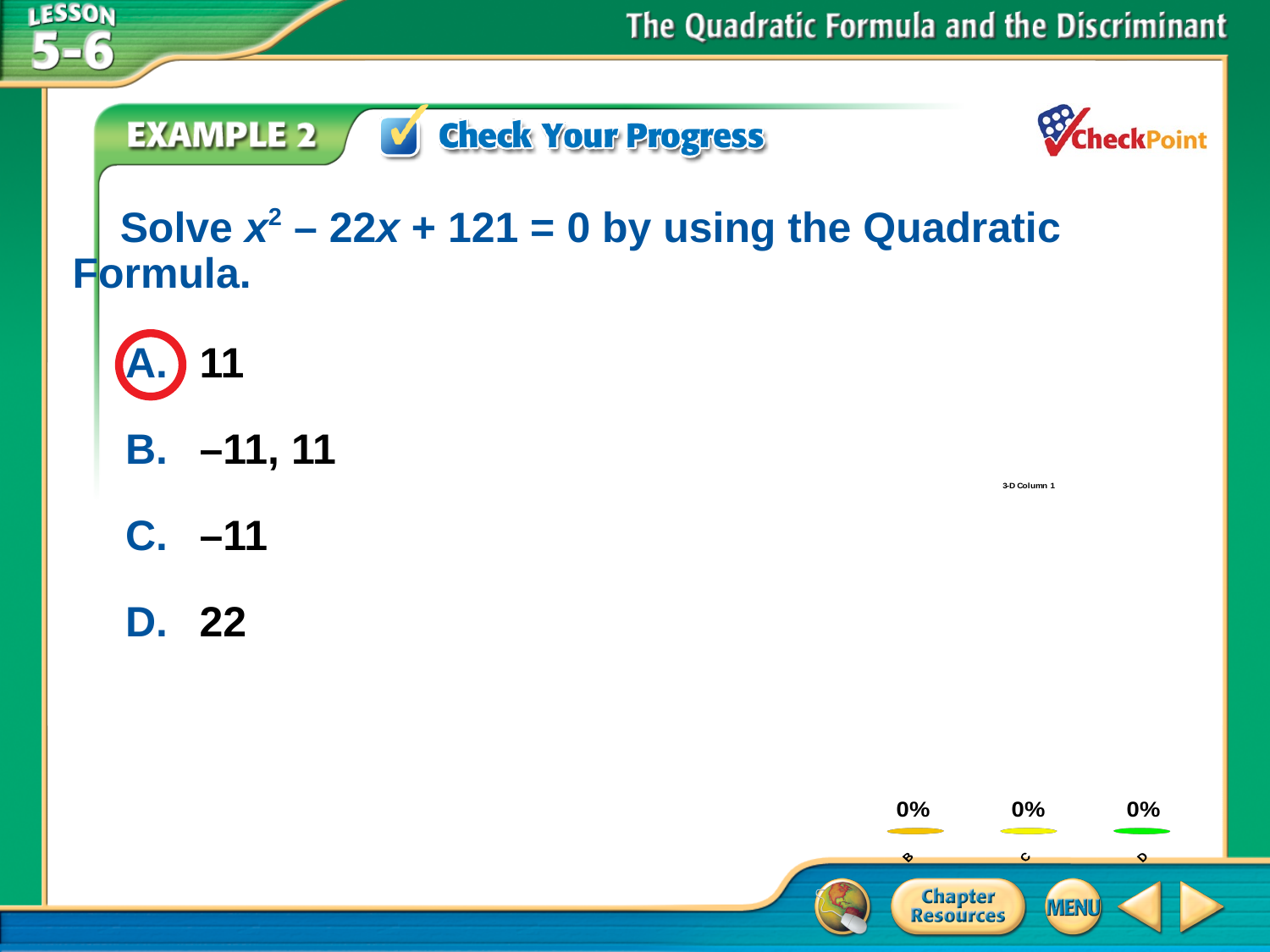
What kind of chart is shown at the bottom right of the slide? bar chart In the chart at the bottom right, what colour is the bar for category D? green In the chart at the bottom right, is the value for category C greater than or equal to the value for category D? equal What is the value shown for category D in the chart at the bottom right of the slide? 0% What is the value shown for category C in the chart at the bottom right of the slide? 0% What is the value shown for category B in the chart at the bottom right of the slide? 0%